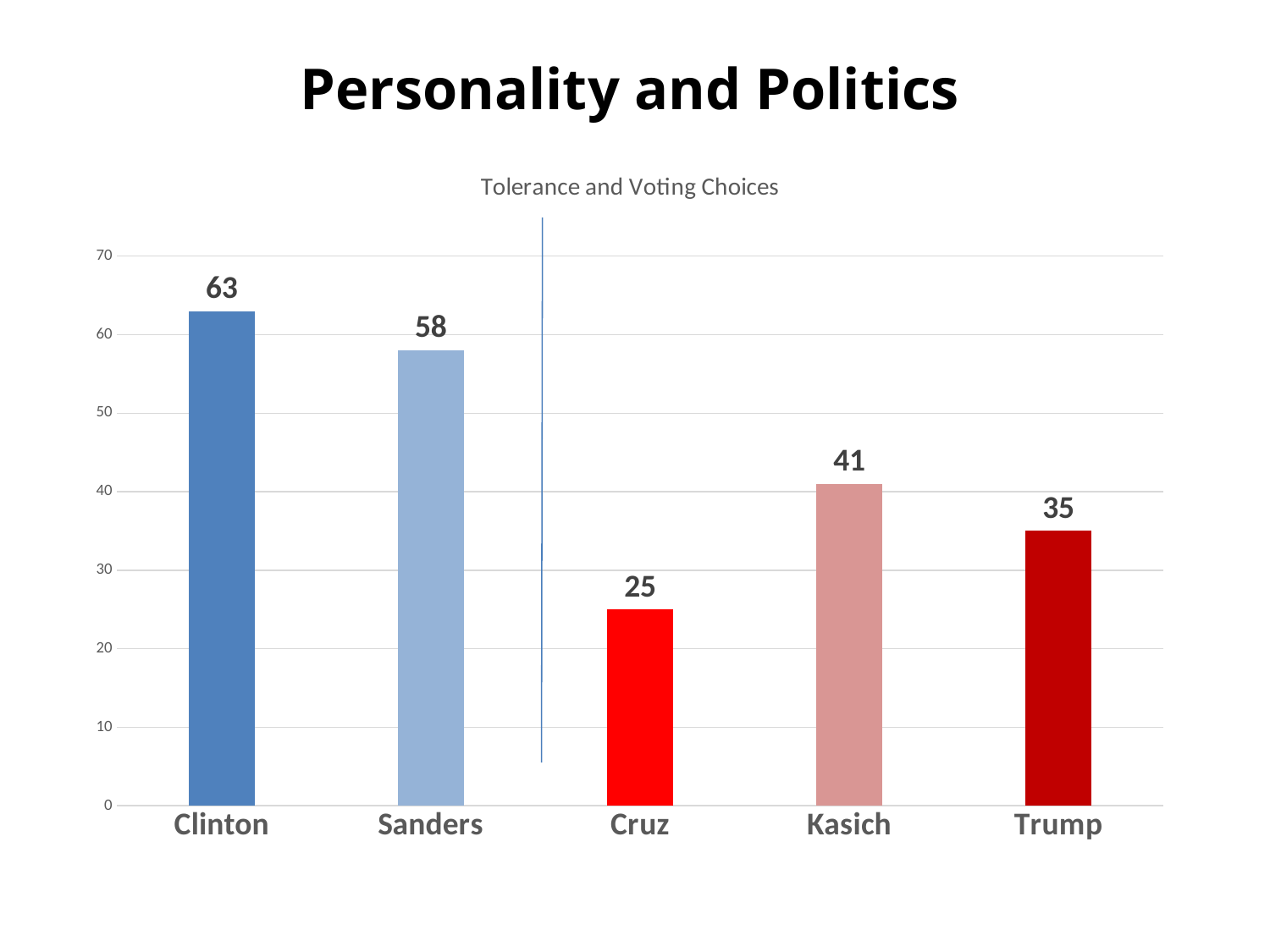
Which candidate has the highest value? Clinton What is the value for Clinton? 63 What is the value for Kasich? 41 How many candidates are shown in the chart? 5 What is the value for Cruz? 25 What is the difference between the values for Kasich and Trump? 6 What is the difference between the values for Clinton and Sanders? 5 What kind of chart is shown on the slide? bar chart Which candidate has the lowest value? Cruz Is the value for Trump greater or less than 40? less Which is larger, the value for Sanders or the value for Trump? Sanders What is the title of the chart? Tolerance and Voting Choices